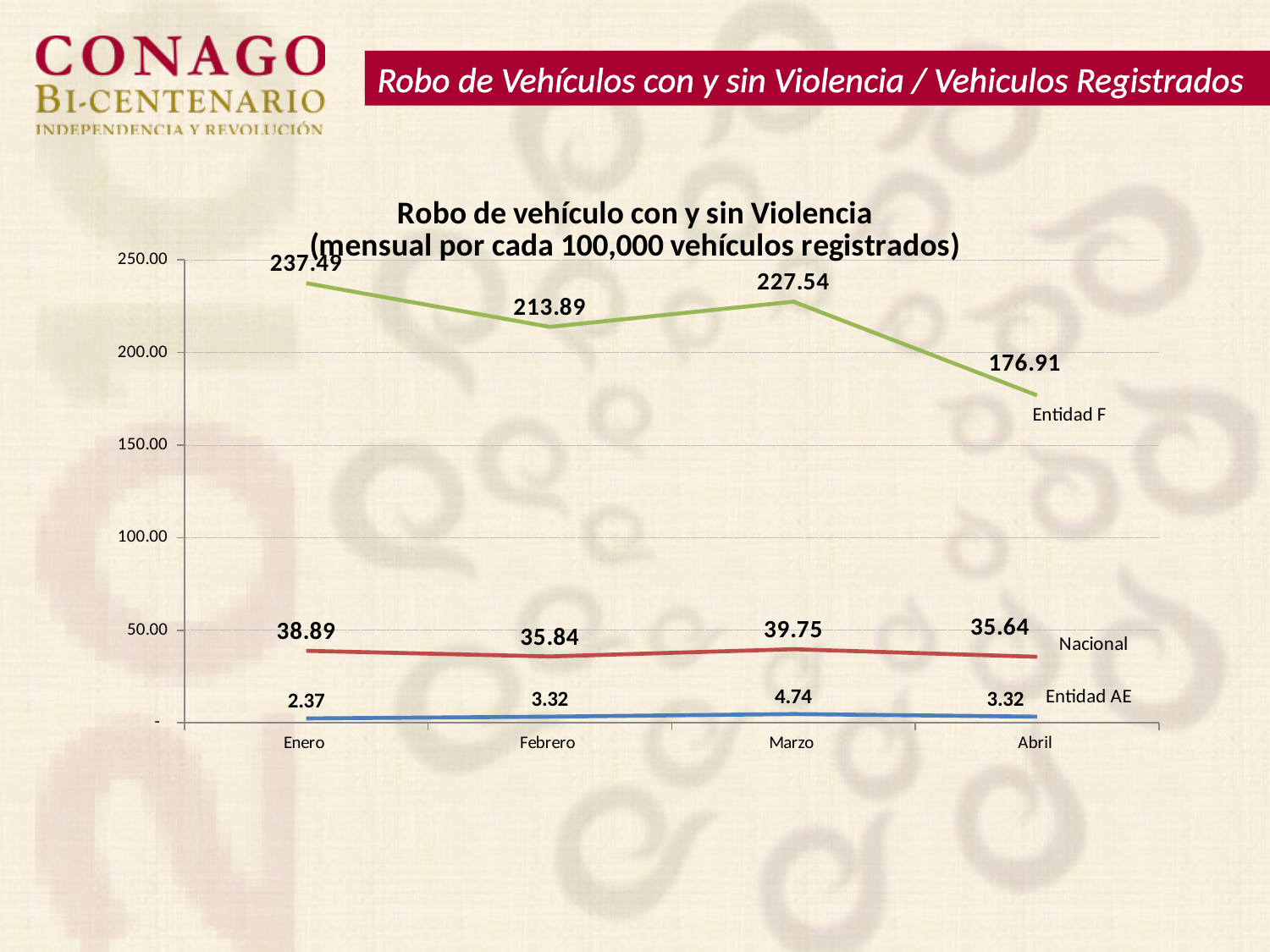
Which is larger, the Nacional value in Enero or in Febrero? Enero In which month is the value for Entidad F lowest? Abril What is the value for Entidad AE in Abril? 3.32 Is the value for Entidad F in Abril greater or less than 200.00? less What kind of chart is shown on the slide? line chart How many series are plotted on the chart? 3 What is the value for Nacional in Marzo? 39.75 What is the difference between the Entidad F values for Enero and Abril? 60.58 How many months are shown on the x axis? 4 What is the value for Entidad F in Enero? 237.49 Does the Entidad F line rise or fall from Marzo to Abril? fall In which month is the value for Entidad AE highest? Marzo